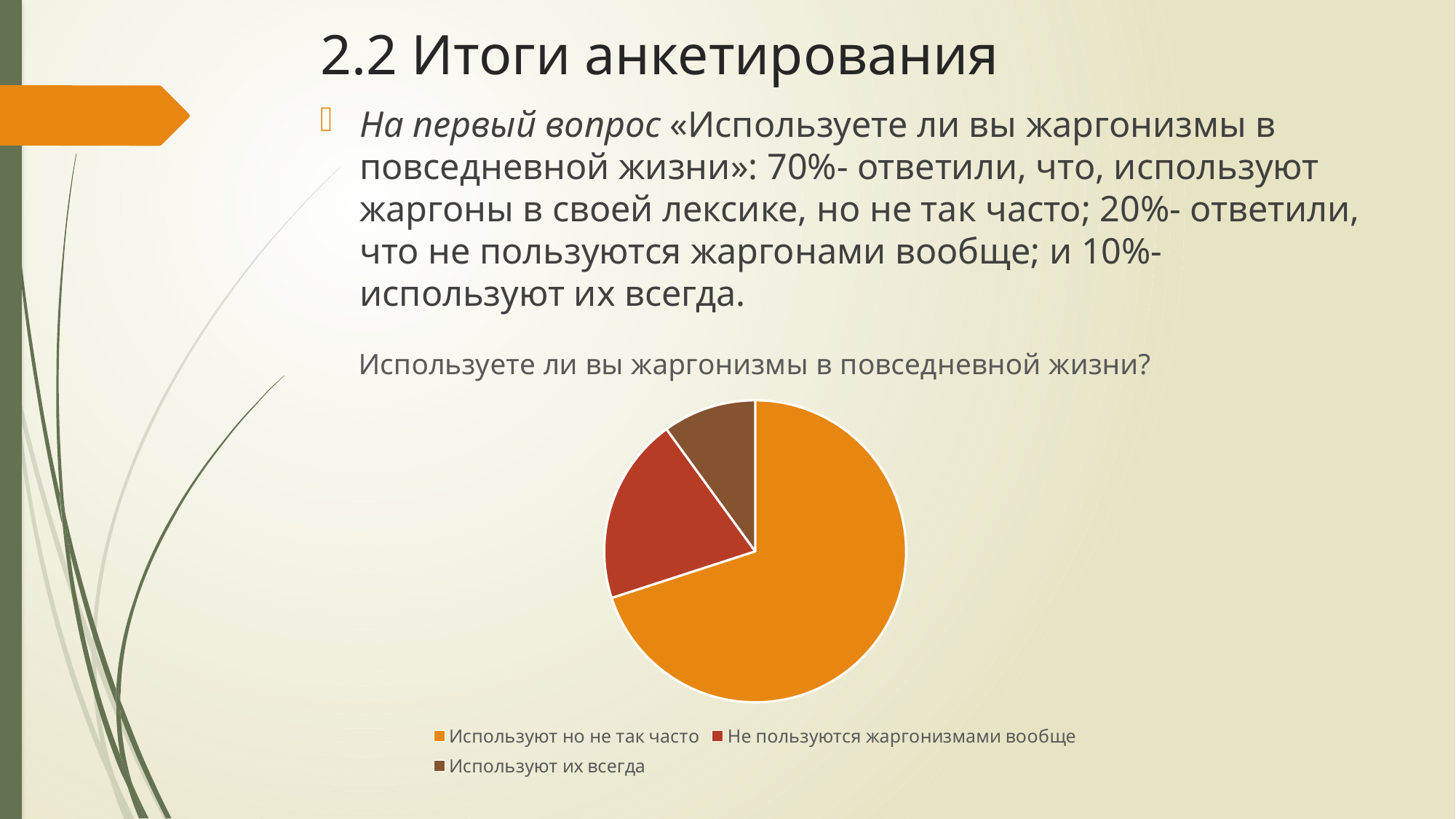
What is the title of the chart? Используете ли вы жаргонизмы в повседневной жизни? Which category has the largest slice of the pie? Используют но не так часто Which slice is larger: "Используют но не так часто" or "Не пользуются жаргонизмами вообще"? Используют но не так часто How many slices does the pie chart have? 3 According to the slide, what share of respondents answered "Используют но не так часто"? 70% Which category has the smallest slice of the pie? Используют их всегда What colour is the slice for "Используют их всегда"? brown How many entries does the chart legend list? 3 According to the slide, what share of respondents answered "Не пользуются жаргонизмами вообще"? 20% What kind of chart is shown on the slide? pie chart According to the slide, what share of respondents answered "Используют их всегда"? 10% Which slice is larger: "Не пользуются жаргонизмами вообще" or "Используют их всегда"? Не пользуются жаргонизмами вообще